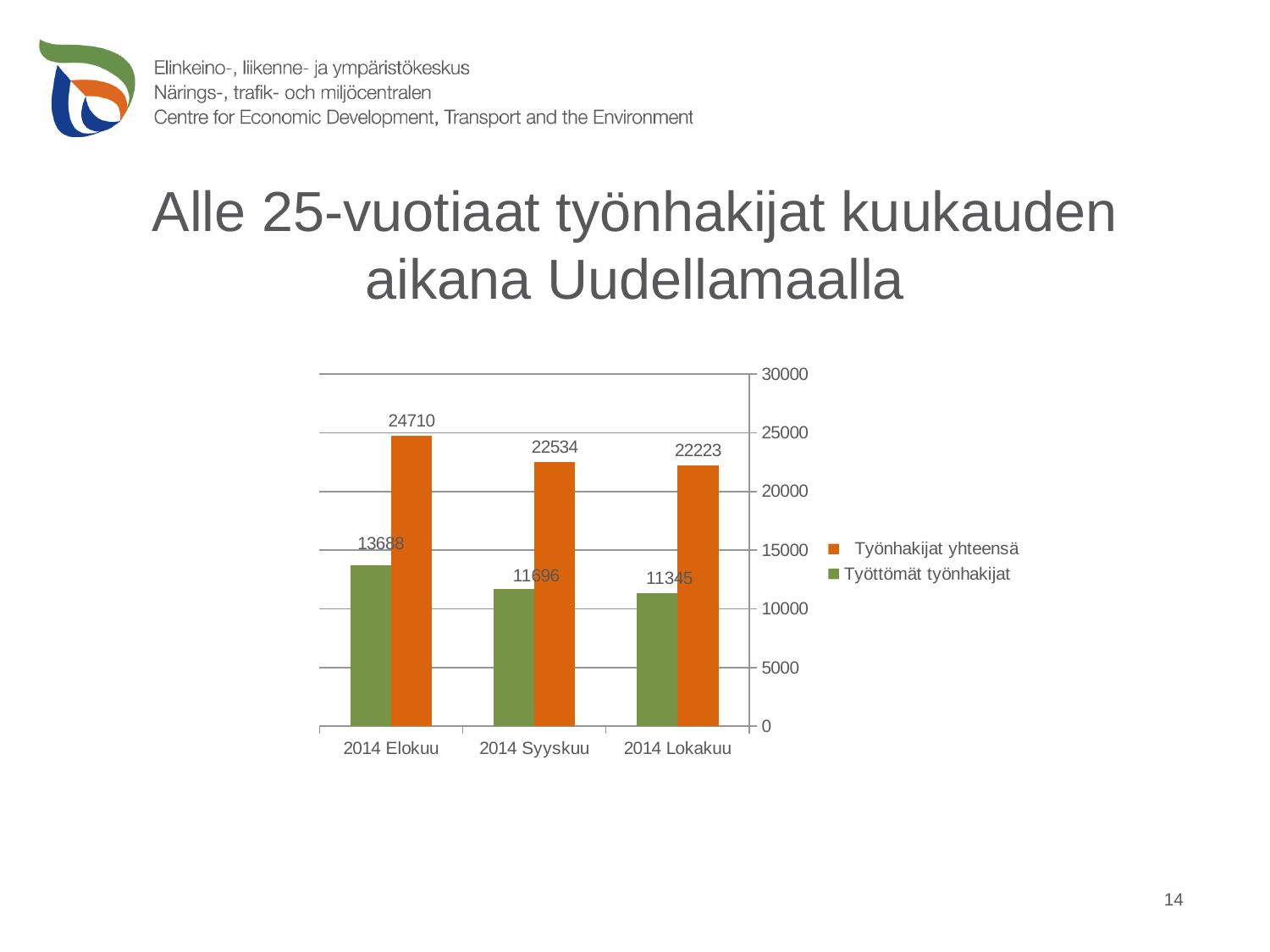
How many months are shown on the x axis? 3 How many series does the legend list? 2 What kind of chart is shown on the slide? bar chart What is the difference between Työnhakijat yhteensä in 2014 Elokuu and 2014 Syyskuu? 2176 What is the value for Työnhakijat yhteensä in 2014 Elokuu? 24710 What is the difference between Työnhakijat yhteensä and Työttömät työnhakijat in 2014 Lokakuu? 10878 Which month has the lowest value for Työttömät työnhakijat? 2014 Lokakuu Which month has the highest value for Työnhakijat yhteensä? 2014 Elokuu Which is larger: Työttömät työnhakijat in 2014 Elokuu or in 2014 Syyskuu? 2014 Elokuu What is the value for Työttömät työnhakijat in 2014 Lokakuu? 11345 Is the value for Työnhakijat yhteensä in 2014 Syyskuu greater or less than 20000? greater What is the value for Työttömät työnhakijat in 2014 Syyskuu? 11696